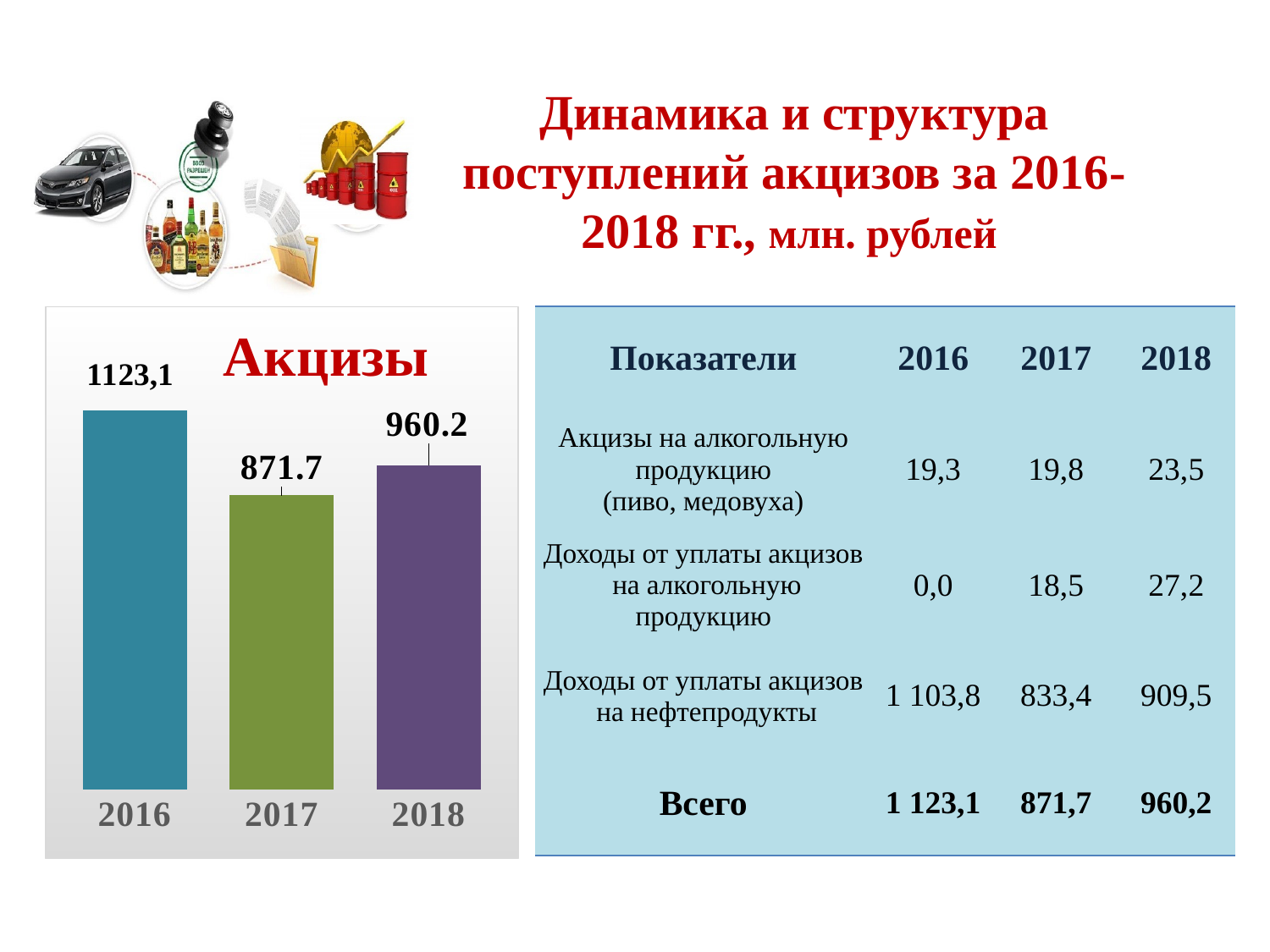
What is the value of the bar for 2018 in the Акцизы chart? 960.2 What is the value of the bar for 2016 in the Акцизы chart? 1123,1 Which year has the lowest bar in the Акцизы chart? 2017 How many bars are shown in the Акцизы chart? 3 Which year has the highest bar in the Акцизы chart? 2016 In the Акцизы chart, what is the difference between the values for 2018 and 2017? 88.5 In the Акцизы chart, does the value rise or fall from 2016 to 2017? fall In the Акцизы chart, which is larger: the value for 2018 or the value for 2017? 2018 In the Акцизы chart, which is larger: the value for 2016 or the value for 2018? 2016 What type of chart is the Акцизы chart? bar chart What is the title of the bar chart on the slide? Акцизы What is the value of the bar for 2017 in the Акцизы chart? 871.7